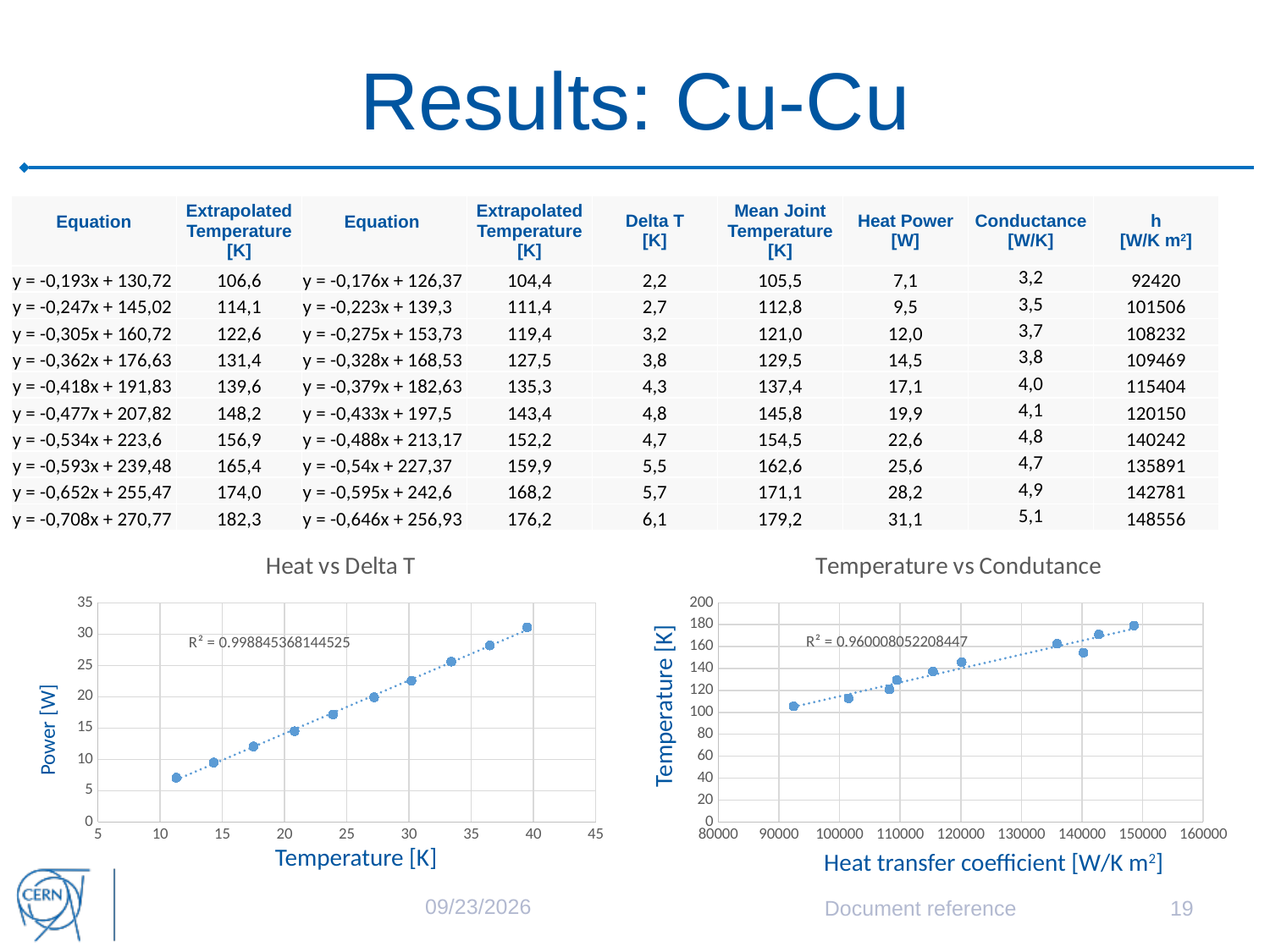
In the 'Temperature vs Condutance' chart, does temperature rise or fall as the heat transfer coefficient increases along the x axis? rise In the 'Heat vs Delta T' chart, does power rise or fall as temperature increases along the x axis? rise What R² value is shown on the 'Temperature vs Condutance' chart? R² = 0.960008052208447 In the 'Heat vs Delta T' chart, is the power of the leftmost point greater or less than 10? less How many data points are plotted in the 'Temperature vs Condutance' chart? 10 In the 'Heat vs Delta T' chart, is the power of the rightmost point greater or less than 25? greater In the 'Temperature vs Condutance' chart, is the temperature of the rightmost point greater or less than 160? greater What kind of chart is the 'Heat vs Delta T' chart? scatter chart What R² value is shown on the 'Heat vs Delta T' chart? R² = 0.998845368144525 How many data points are plotted in the 'Heat vs Delta T' chart? 10 What kind of chart is the 'Temperature vs Condutance' chart? scatter chart